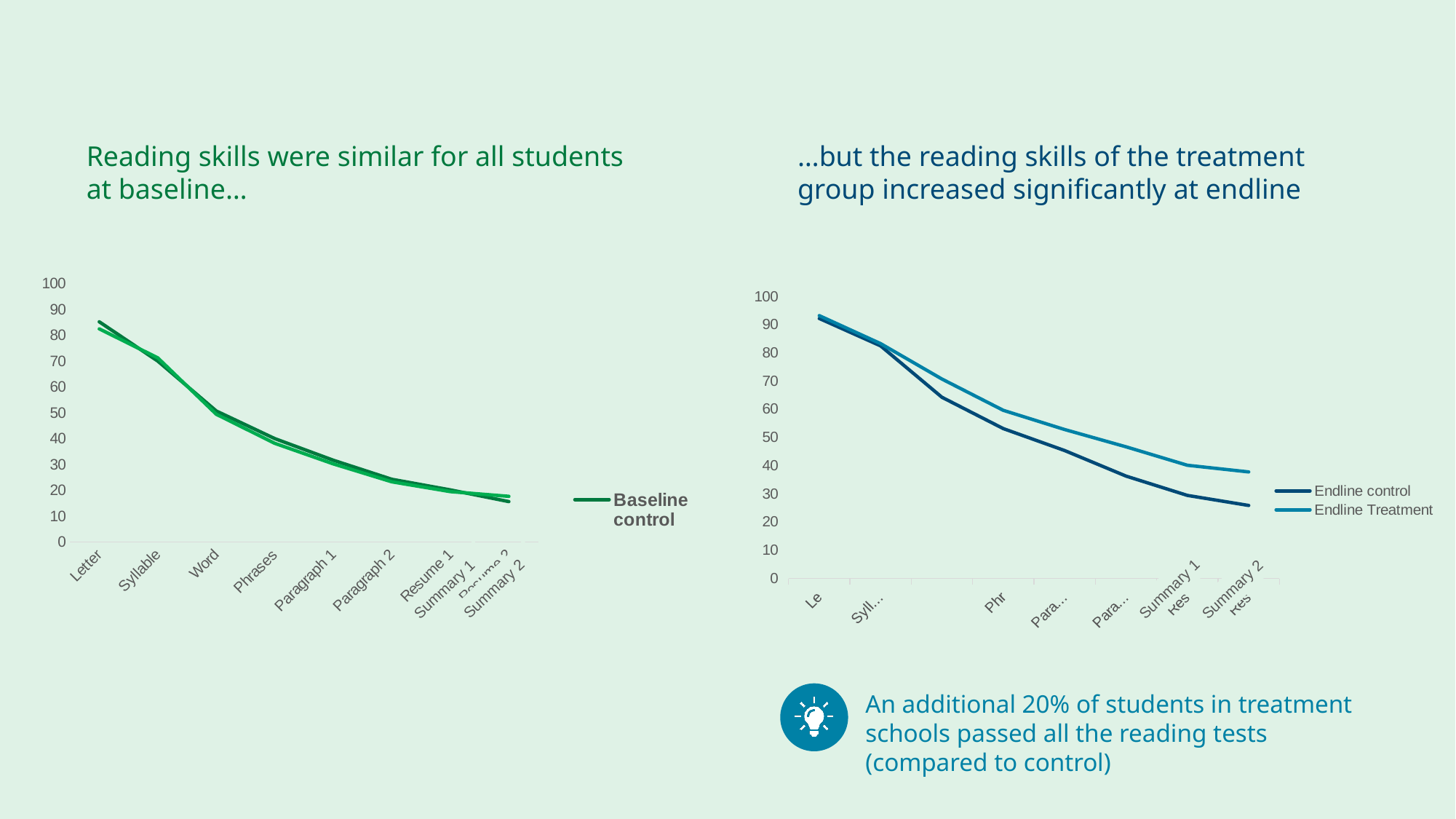
What is the name of the series shown in the legend of the left-hand chart? Baseline control In the left-hand chart, which category has the highest value for Baseline control? Letter In the left-hand chart, is the value for Baseline control at Letter greater or less than 80? greater In the right-hand chart, at Summary 2, which series has the larger value, Endline control or Endline Treatment? Endline Treatment In the left-hand chart, do the values rise or fall along the x axis? fall What kind of chart is shown on the right side of the slide? line chart In the left-hand chart, is the value for Baseline control at Summary 2 greater or less than 20? less In the right-hand chart, is the value for Endline control at Summary 2 greater or less than 30? less What kind of chart is shown on the left side of the slide? line chart In the right-hand chart, do the values rise or fall along the x axis? fall How many series does the legend of the right-hand chart list? 2